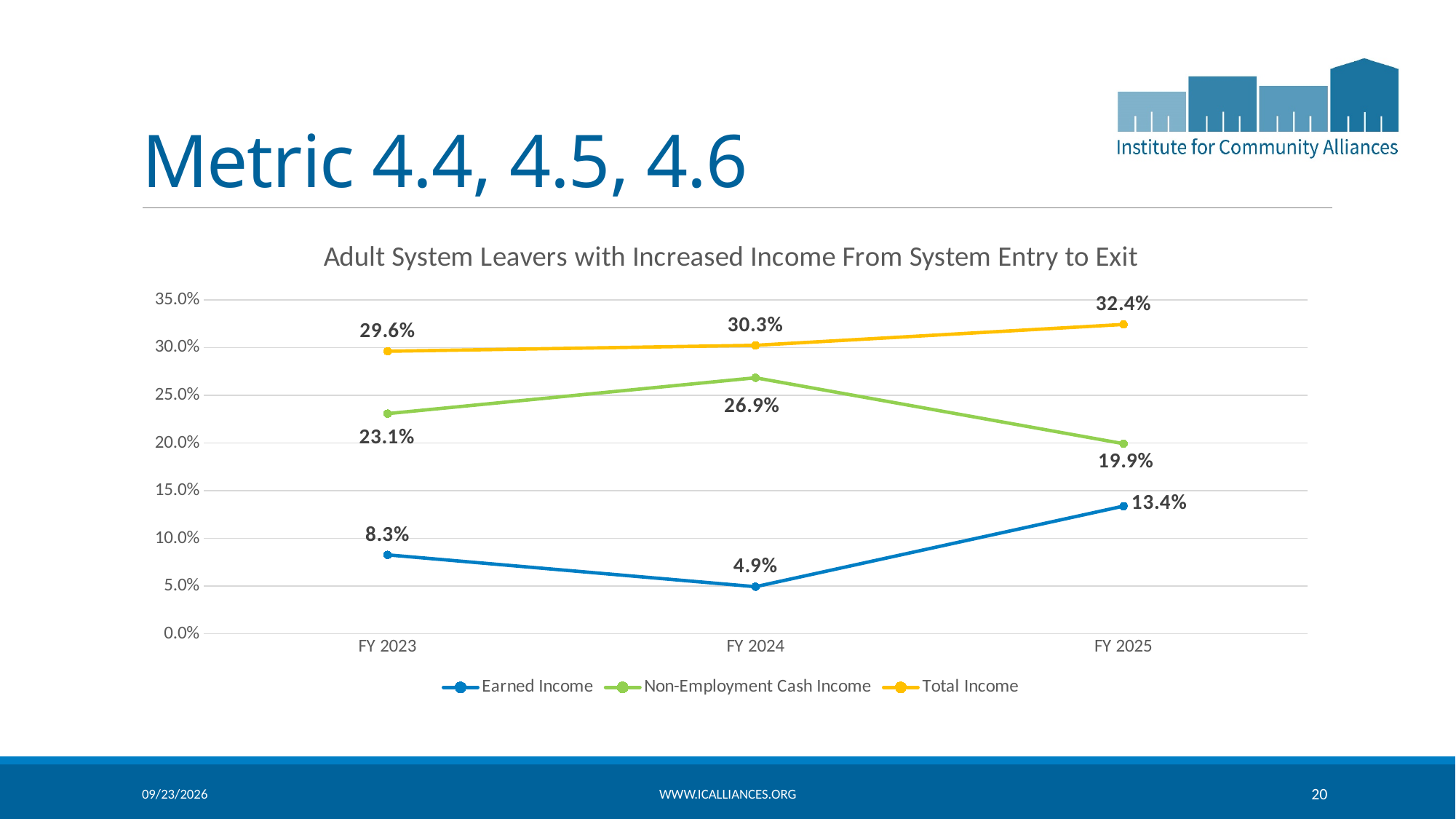
What is the Total Income value for FY 2025? 32.4% What is the difference between Total Income in FY 2025 and FY 2023? 2.8% Which is larger in FY 2023: Earned Income or Non-Employment Cash Income? Non-Employment Cash Income What is the Non-Employment Cash Income value for FY 2023? 23.1% What is the Earned Income value for FY 2024? 4.9% What is the difference between Non-Employment Cash Income and Earned Income in FY 2025? 6.5% How many series does the legend list? 3 In which fiscal year is Earned Income lowest? FY 2024 What kind of chart is shown on the slide? Line chart Does Total Income rise or fall from FY 2023 to FY 2025? Rise In which fiscal year is Non-Employment Cash Income highest? FY 2024 How many fiscal years are shown on the x axis? 3